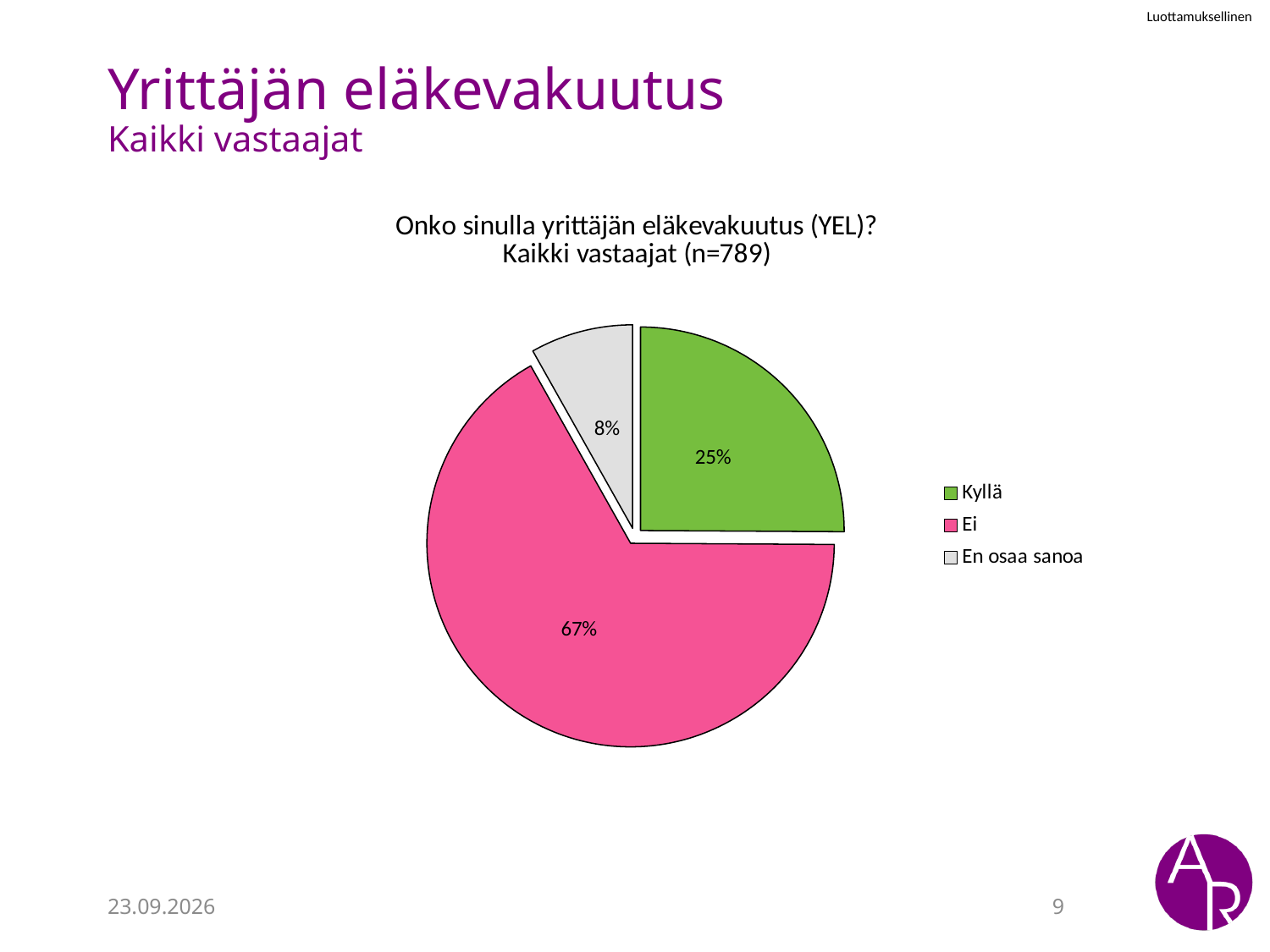
Which is larger, the share for "Kyllä" or the share for "En osaa sanoa"? Kyllä What colour is the "Ei" slice? Pink How many entries does the legend list? 3 What is the difference in percentage points between the "Ei" and "Kyllä" shares? 42 What share of respondents answered "En osaa sanoa"? 8% Which answer has the largest share of the pie? Ei What kind of chart is shown on the slide? Pie chart What share of respondents answered "Ei"? 67% How many slices does the pie chart have? 3 How many respondents (n) does the chart title state? 789 What share of respondents answered "Kyllä"? 25% Which answer has the smallest share of the pie? En osaa sanoa